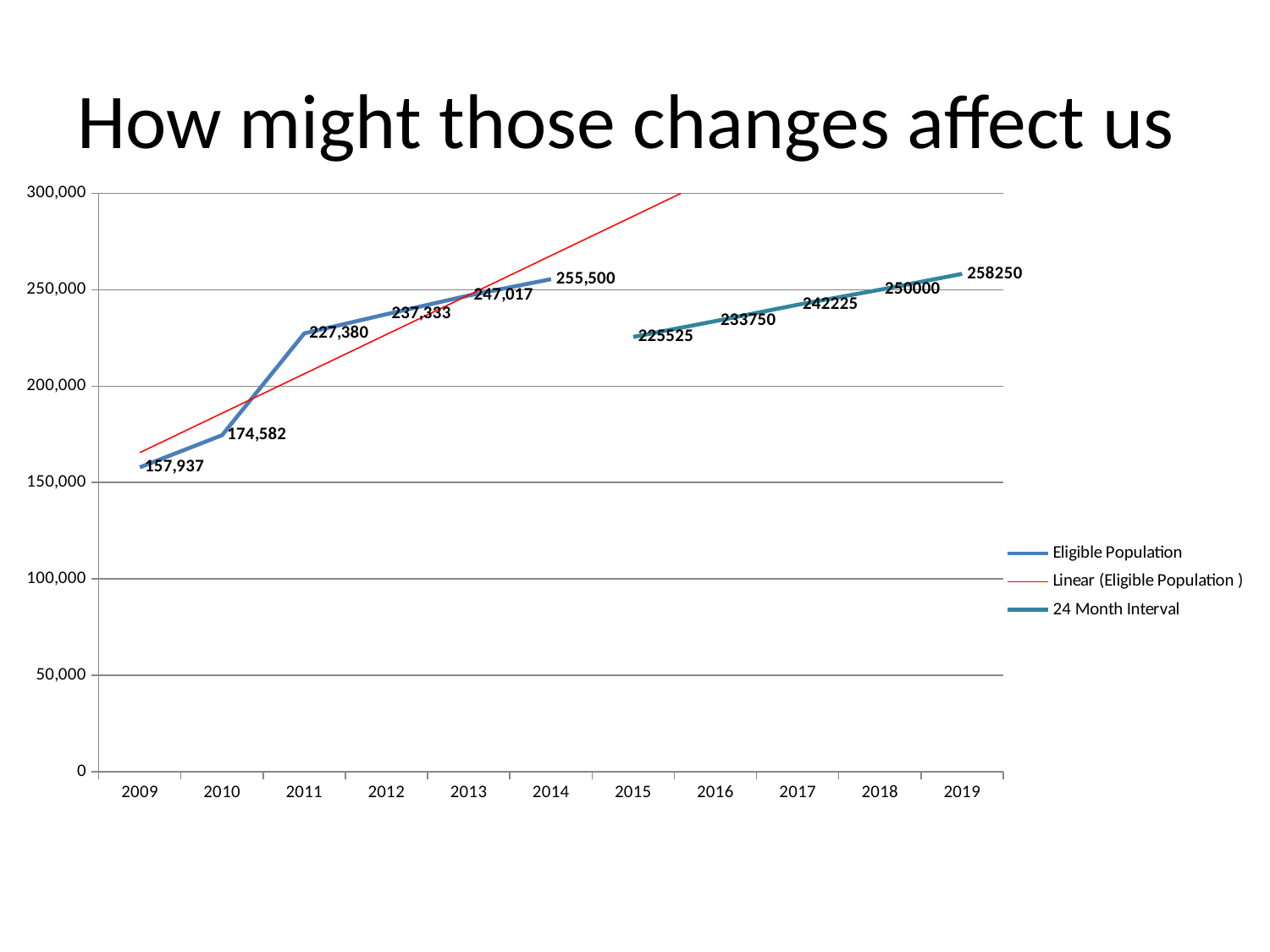
Do the Eligible Population values rise or fall from 2009 to 2014? Rise Is the Eligible Population value for 2010 greater or less than 200,000? less What is the 24 Month Interval value for 2017? 242225 What is the Eligible Population value for 2009? 157,937 What kind of chart is shown on the slide? Line chart Which year has the highest 24 Month Interval value? 2019 Which year has the lowest Eligible Population value? 2009 Which is larger, the Eligible Population value for 2014 or the 24 Month Interval value for 2015? Eligible Population value for 2014 What is the 24 Month Interval value for 2019? 258250 What is the Eligible Population value for 2014? 255,500 What is the difference between the Eligible Population values for 2011 and 2010? 52,798 How many series does the legend list? 3